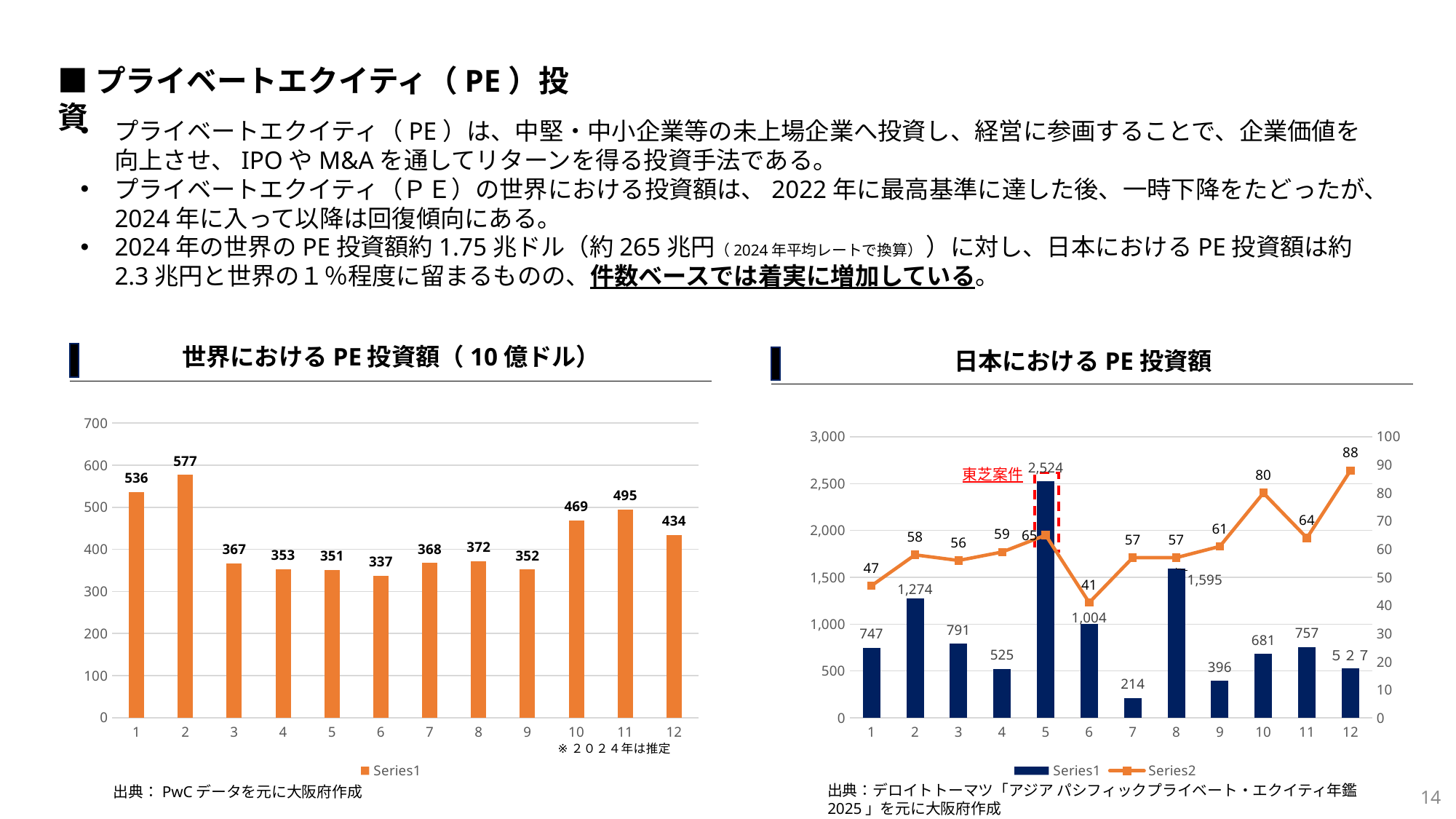
In the chart titled 日本におけるPE投資額, how many series does the legend list? 2 In the chart titled 世界におけるPE投資額（10億ドル）, how many bars are plotted? 12 In the chart titled 日本におけるPE投資額, what is the difference between the Series2 values for category 10 and category 11? 16 In the chart titled 世界におけるPE投資額（10億ドル）, which category has the lowest value? 6 In the chart titled 世界におけるPE投資額（10億ドル）, what kind of chart is shown? Bar chart In the chart titled 世界におけるPE投資額（10億ドル）, what is the difference between the values for category 11 and category 12? 61 In the chart titled 世界におけるPE投資額（10億ドル）, what is the value for category 2? 577 In the chart titled 日本におけるPE投資額, which category has the highest Series2 value? 12 In the chart titled 日本におけるPE投資額, which category has the lowest Series1 value? 7 In the chart titled 日本におけるPE投資額, is the Series1 value for category 8 larger than the Series1 value for category 2? Yes In the chart titled 日本におけるPE投資額, what is the Series1 value for category 5? 2,524 In the chart titled 日本におけるPE投資額, what is the Series2 value for category 12? 88